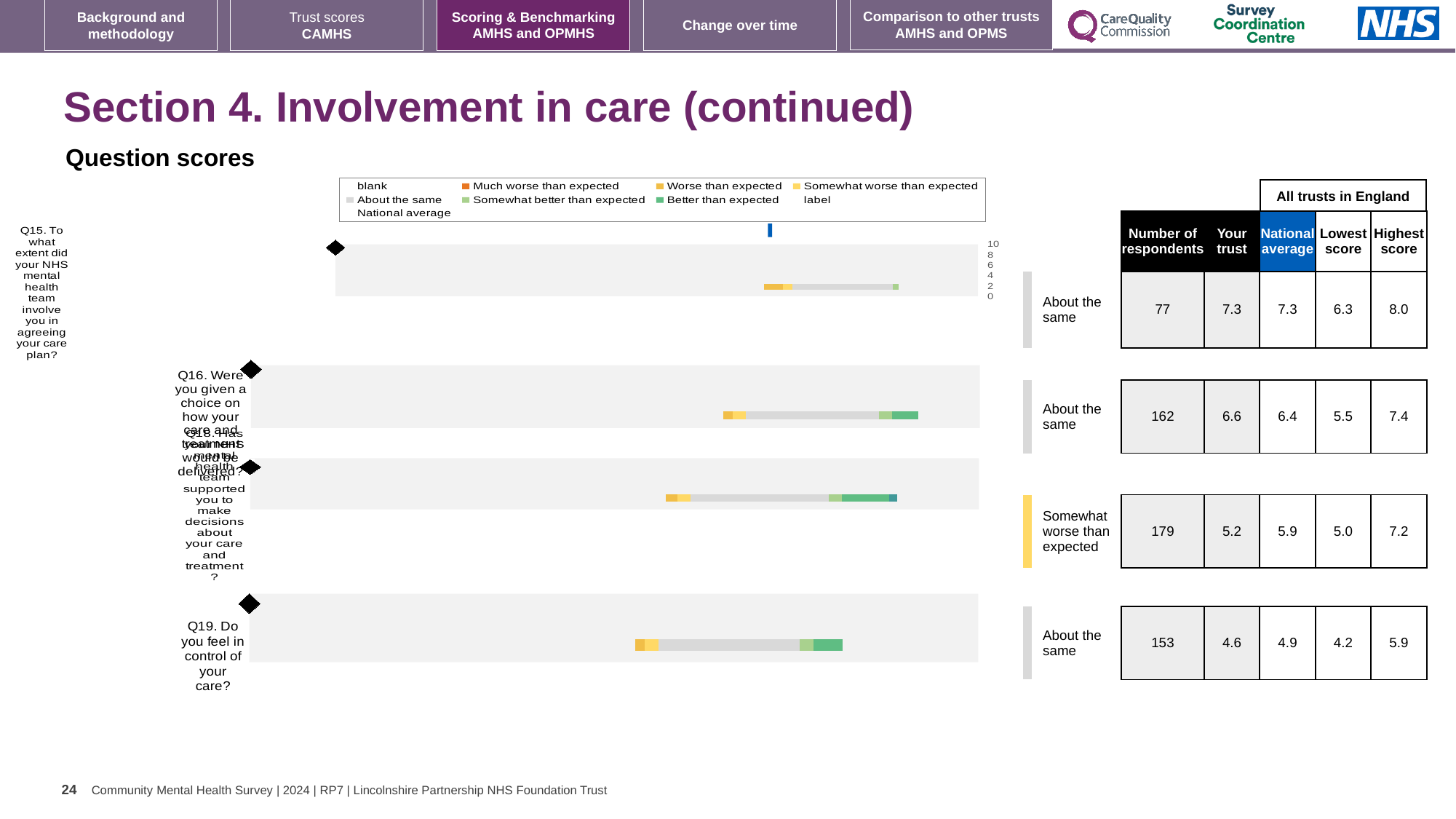
Which benchmark category is shown for Q18 (supported to make decisions about your care and treatment)? Somewhat worse than expected How many respondents are listed for Q19 (Do you feel in control of your care)? 153 Which question has the lowest 'Your trust' score? Q19 What kind of chart is used to show the question scores on this slide? bar chart How many questions are plotted in the question scores chart? 4 What is the 'Your trust' score for Q15 (involving you in agreeing your care plan)? 7.3 What is the highest score among all trusts in England for Q16? 7.4 What is the lowest score among all trusts in England for Q19? 4.2 Which question has the highest 'Your trust' score? Q15 For Q18, which is larger: the 'Your trust' score or the national average? National average What is the difference between the highest score and the lowest score for Q15? 1.7 What is the difference between the 'Your trust' score and the national average for Q16? 0.2